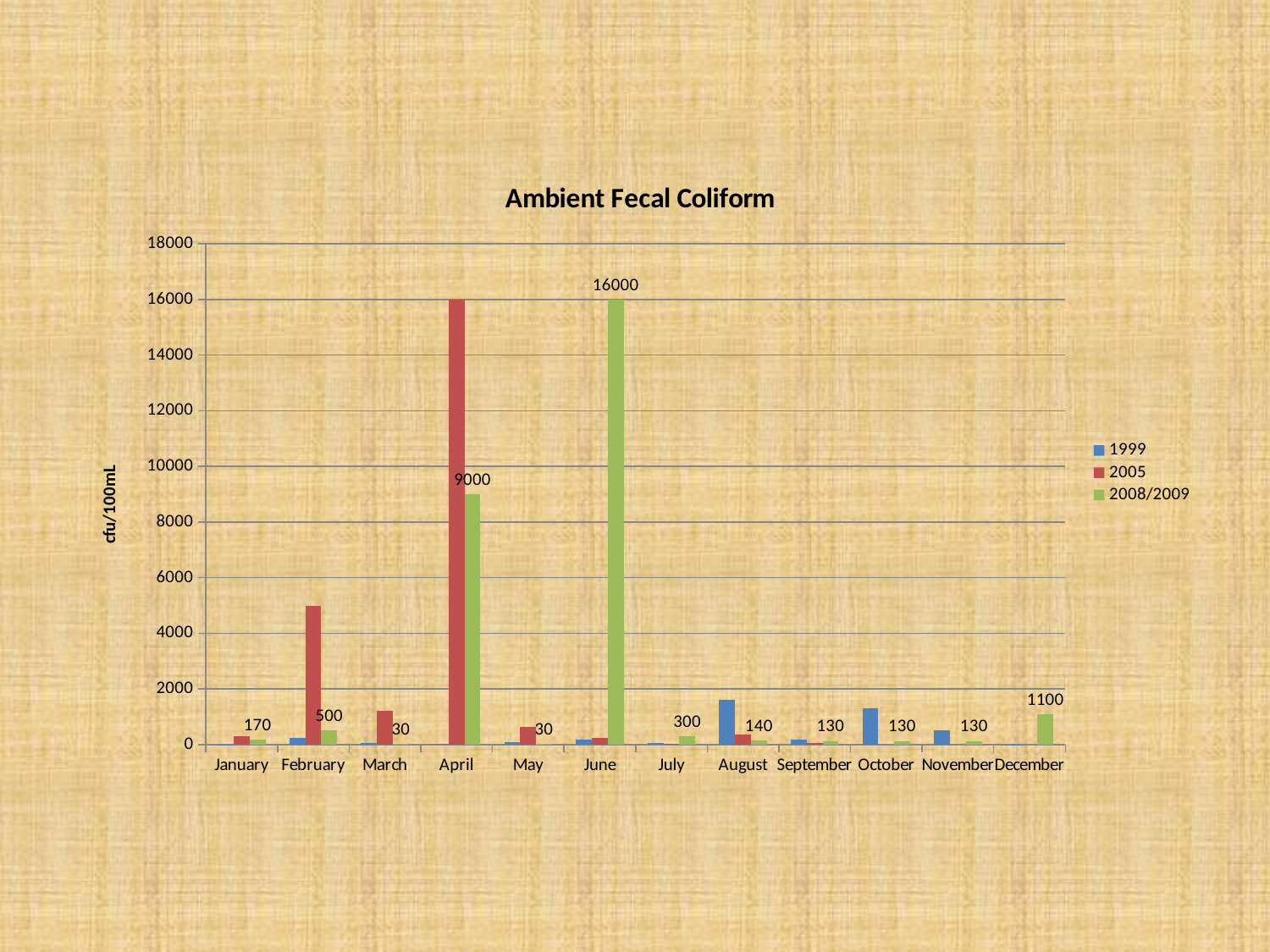
What is the 2008/2009 value for April? 9000 What is the 2008/2009 value for December? 1100 What is the difference between the 2008/2009 values for June and April? 7000 What is the 2008/2009 value for June? 16000 Which month has the highest 2008/2009 value? June What type of chart is shown on the slide? bar chart Is the 2005 value for April greater or less than 14000? greater How many months are shown on the x axis? 12 How many series does the legend list? 3 Which is larger, the 2008/2009 value for February or the 2008/2009 value for July? February What is the title of the chart? Ambient Fecal Coliform Is the 2005 value for February greater or less than 4000? greater